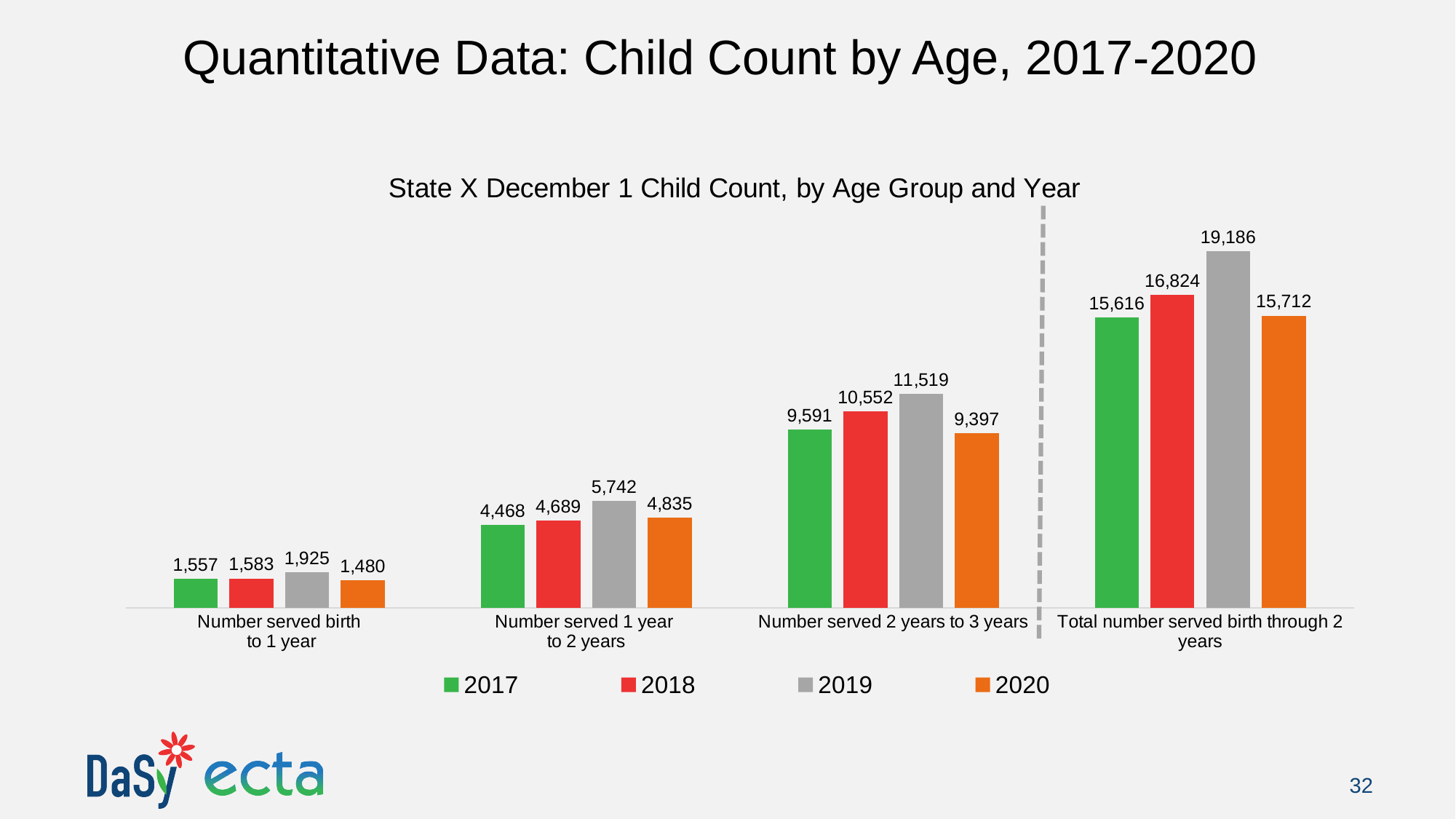
How many series does the legend list? 4 Which colour represents 2019 in the legend? Gray What is the number served 2 years to 3 years in 2020? 9,397 What is the title of the chart? State X December 1 Child Count, by Age Group and Year What kind of chart is shown on the slide? Bar chart What is the difference between the 2019 and 2018 values for number served 1 year to 2 years? 1,053 What is the number served birth to 1 year in 2019? 1,925 How many age-group categories are shown on the x axis? 4 Which year has the lowest number served birth to 1 year? 2020 Which year has the highest total number served birth through 2 years? 2019 Which is larger: the 2017 or the 2020 value for number served 1 year to 2 years? 2020 What is the total number served birth through 2 years in 2018? 16,824